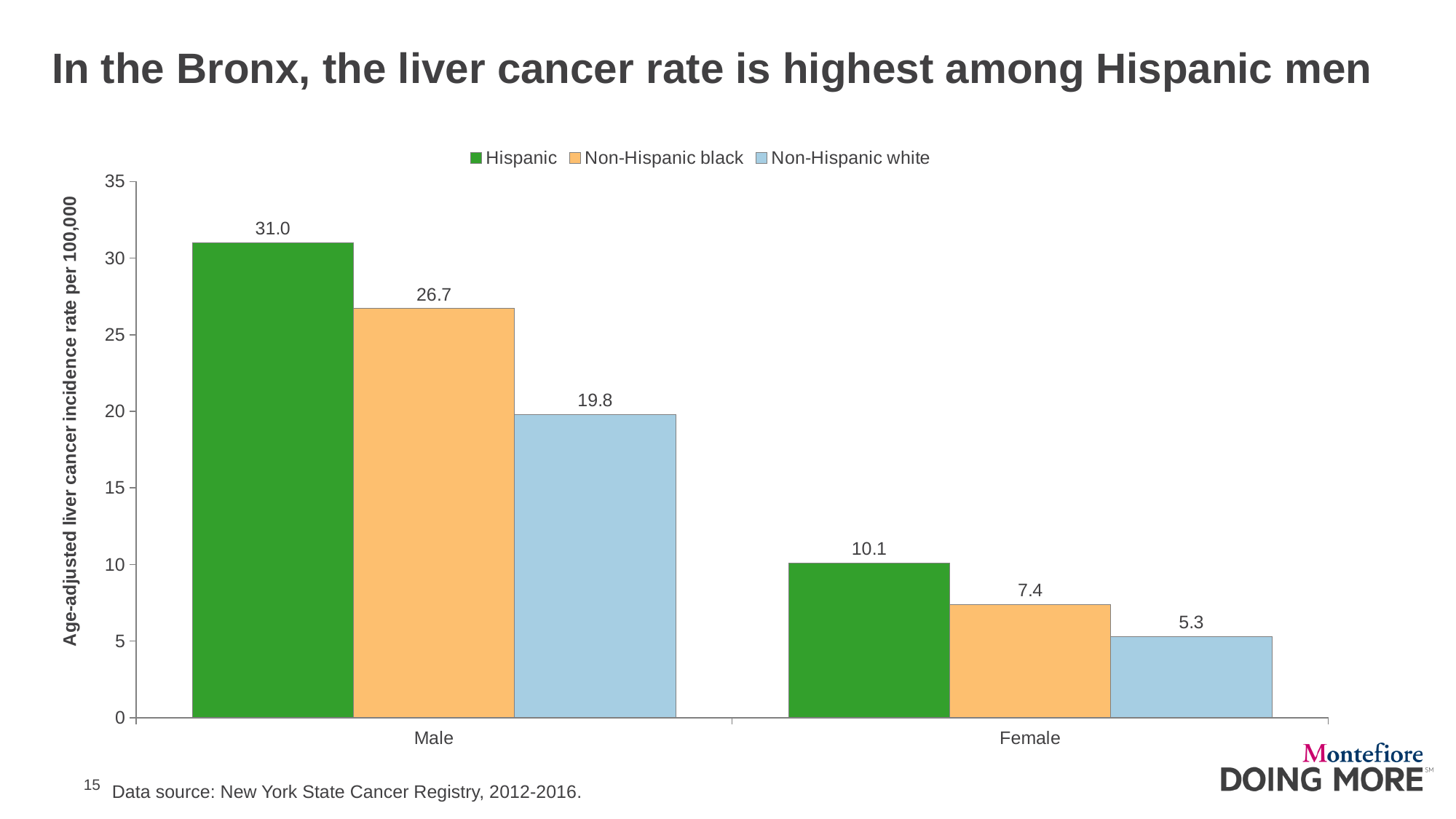
How many series does the legend list? 3 What is the label of the vertical axis? Age-adjusted liver cancer incidence rate per 100,000 Which group has the highest liver cancer incidence rate among females? Hispanic What is the liver cancer incidence rate for Hispanic males? 31.0 Which is larger, the Non-Hispanic black male rate or the Hispanic female rate? Non-Hispanic black male rate Which group has the lowest liver cancer incidence rate among males? Non-Hispanic white What is the liver cancer incidence rate for Non-Hispanic white females? 5.3 What kind of chart is shown on the slide? Bar chart What is the liver cancer incidence rate for Non-Hispanic black males? 26.7 Is the value for Non-Hispanic white males greater or less than 20? less What is the difference between the Hispanic female rate and the Non-Hispanic black female rate? 2.7 What is the difference between the Hispanic male rate and the Non-Hispanic white male rate? 11.2